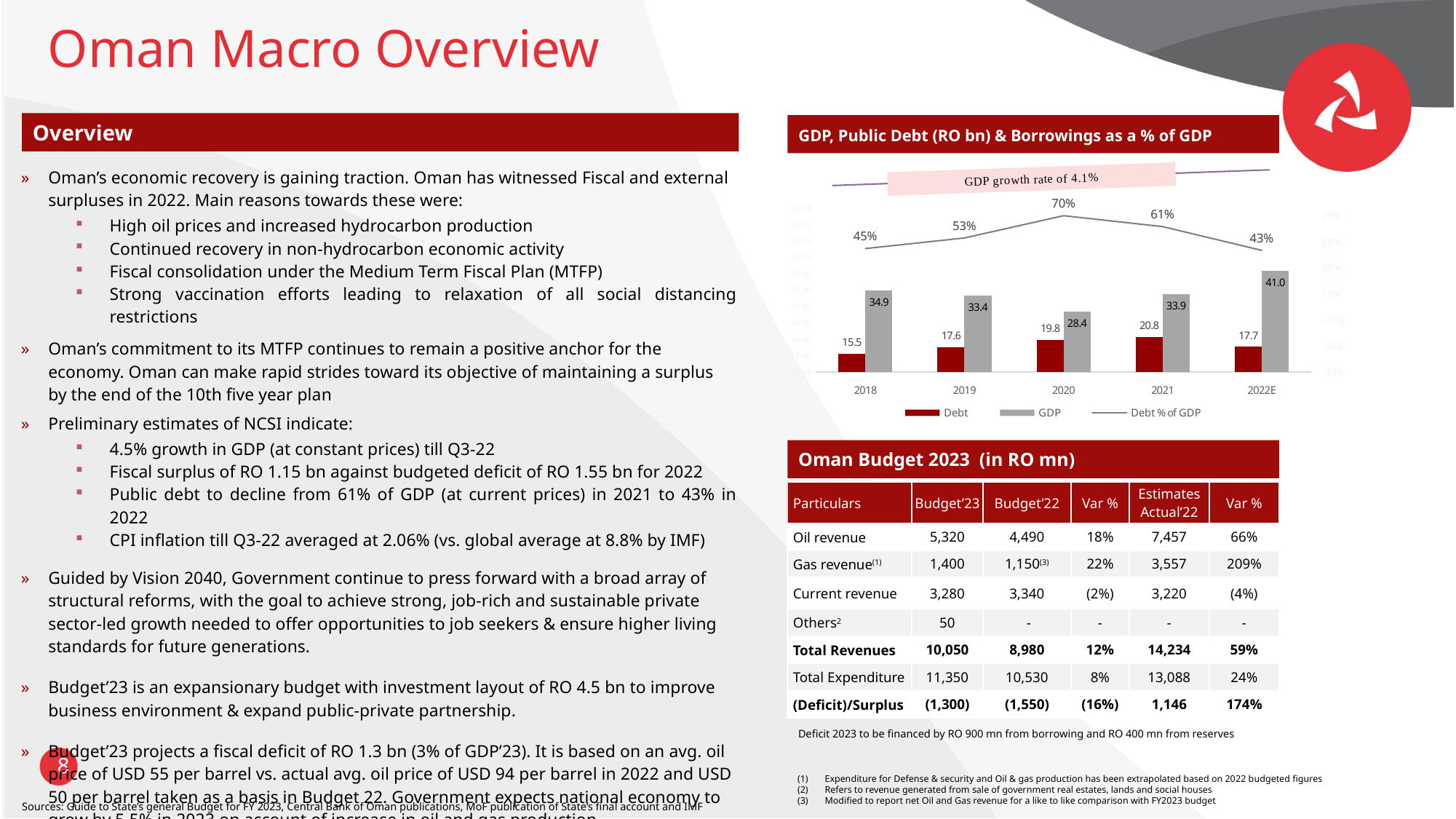
What kind of chart is used for the Debt and GDP series? Bar chart What is the Debt % of GDP for 2021 in the chart? 61% What is the GDP value for 2022E in the chart? 41.0 In which year is the Debt % of GDP highest in the chart? 2020 What is the difference between the GDP and Debt values for 2018 in the chart? 19.4 Which is larger in the chart: the Debt value for 2021 or the Debt value for 2022E? 2021 In which year is the GDP bar lowest in the chart? 2020 What GDP growth rate is stated in the annotation at the top of the chart? 4.1% What is the Debt value for 2020 in the GDP, Public Debt & Borrowings chart? 19.8 Does the Debt % of GDP line rise or fall from 2020 to 2022E in the chart? Fall How many years are shown on the x axis of the chart? 5 How many series does the chart's legend list? 3